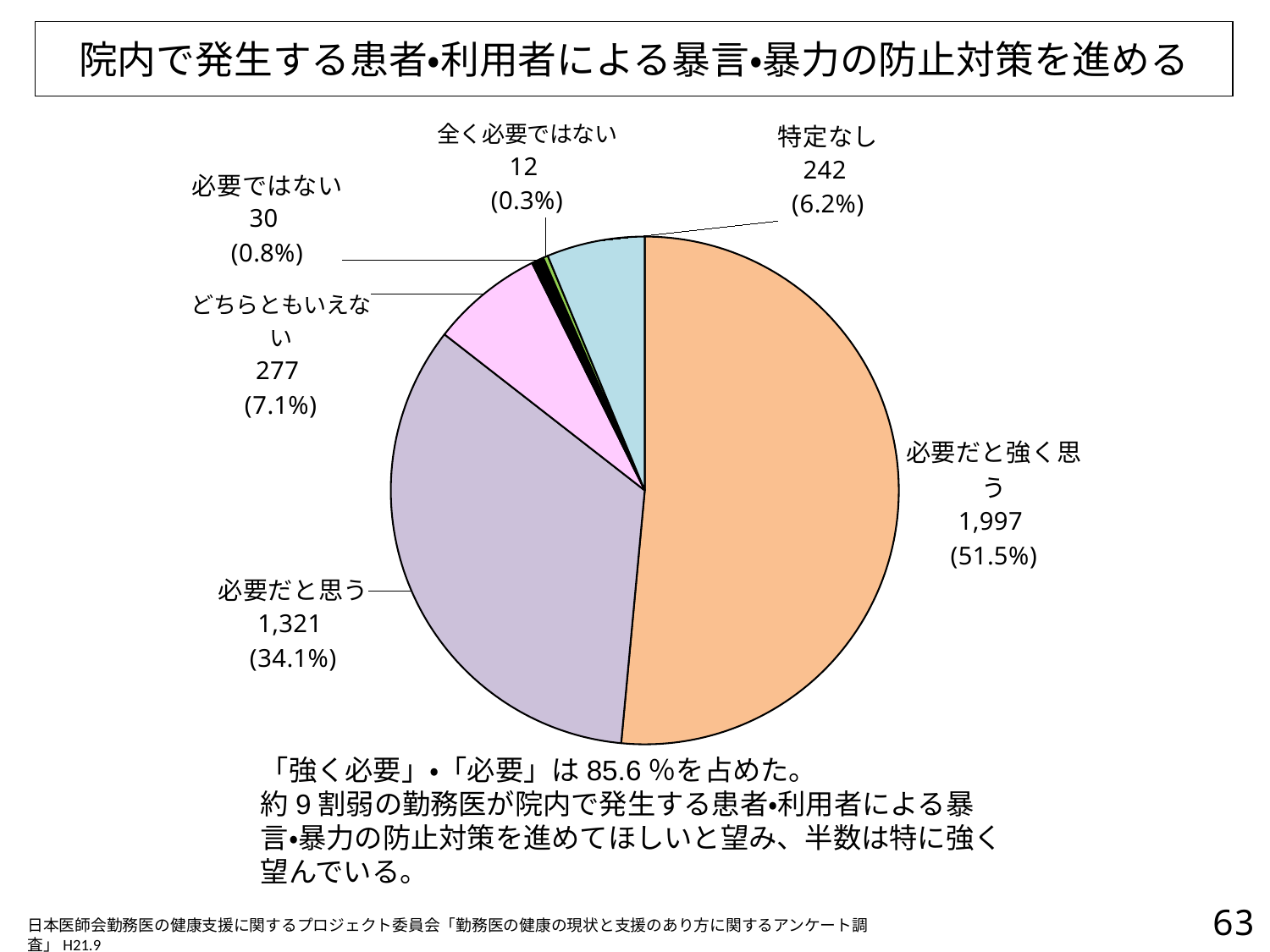
What kind of chart is shown on the slide? pie chart What is the title of the slide? 院内で発生する患者•利用者による暴言•暴力の防止対策を進める What is the difference in count between 必要だと強く思う and 必要だと思う? 676 Which category has the smallest slice? 全く必要ではない How many slices does the pie chart have? 6 What is the count for 必要だと強く思う? 1,997 What is the count for 必要ではない? 30 Which is larger, the count for 特定なし or the count for どちらともいえない? どちらともいえない What is the count for どちらともいえない? 277 Which category has the largest slice? 必要だと強く思う What percentage share does 必要だと思う have? 34.1% What percentage share does 特定なし have? 6.2%